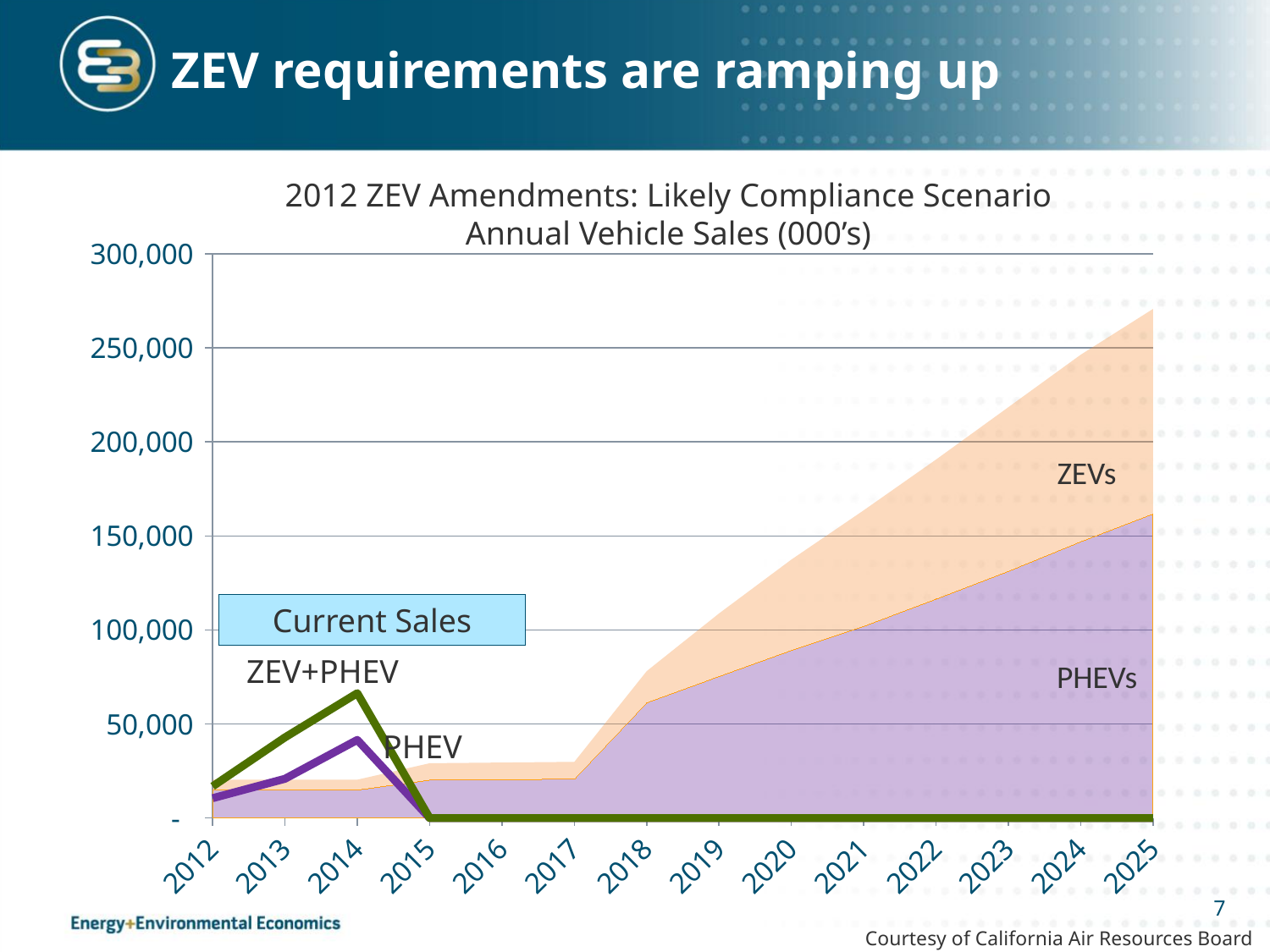
Is the total projected sales (top of the ZEVs area) in 2016 greater or less than 50,000? less How many years are shown on the x axis of the chart? 14 Is the PHEV current sales line in 2014 greater or less than 50,000? less What kind of chart is shown on the slide? Area and line chart (stacked areas with two lines) In which year is the total projected sales highest? 2025 What is the title of the chart? 2012 ZEV Amendments: Likely Compliance Scenario Annual Vehicle Sales (000's) Is the total projected sales (top of the ZEVs area) in 2018 greater or less than 100,000? less What are the two shaded areas in the chart labelled? ZEVs and PHEVs Do the projected sales rise or fall from 2018 to 2025? rise